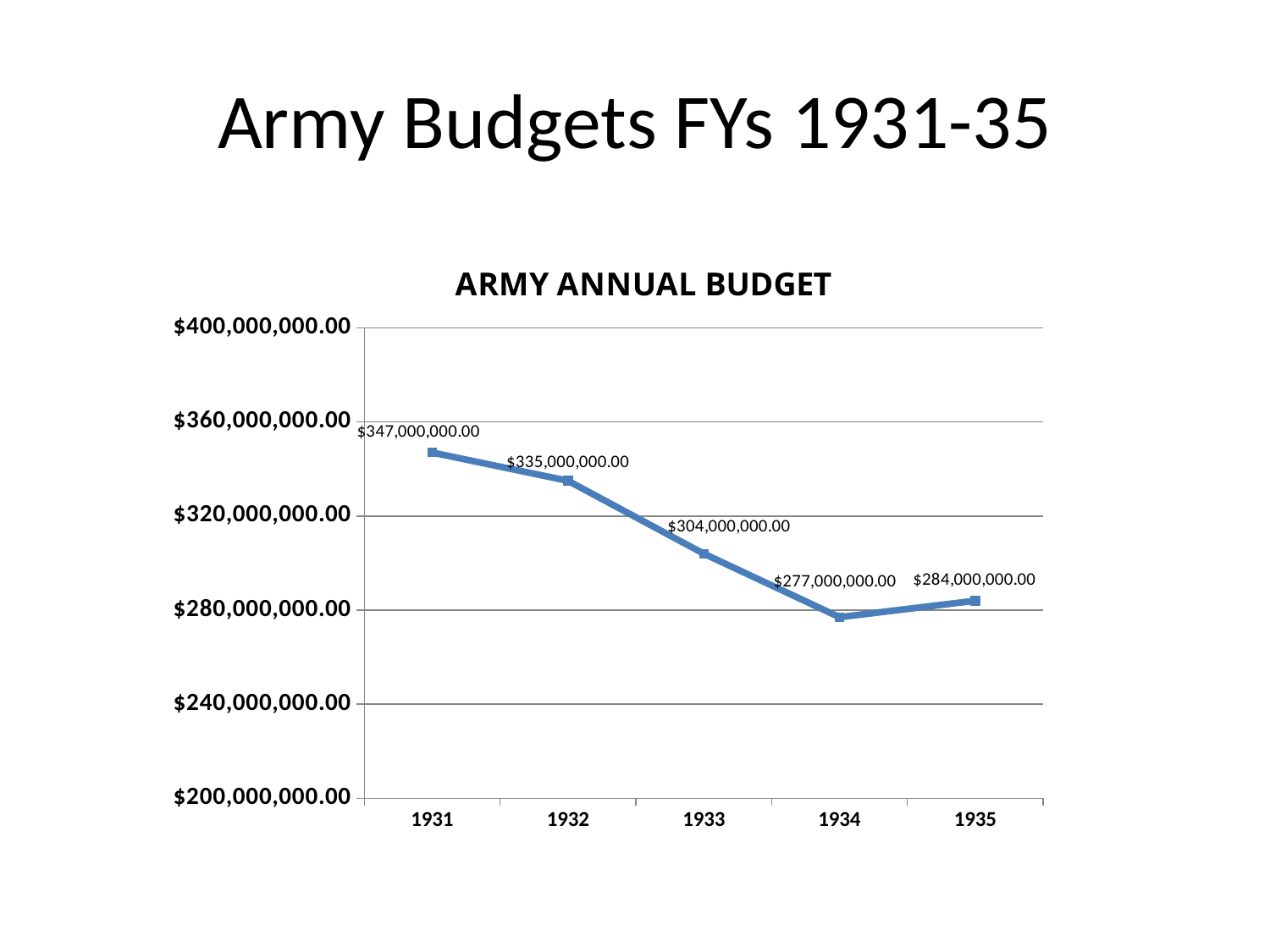
Is the value for 1933 greater or less than $320,000,000.00? less Which year has the lowest Army annual budget? 1934 What kind of chart is shown? line chart What is the difference between the 1931 and 1932 budgets? $12,000,000.00 How many years are plotted on the chart? 5 What is the Army annual budget for 1931? $347,000,000.00 Which year has the highest Army annual budget? 1931 What is the Army annual budget for 1935? $284,000,000.00 What is the Army annual budget for 1934? $277,000,000.00 Which year has a larger budget, 1934 or 1935? 1935 What is the difference between the 1933 and 1934 budgets? $27,000,000.00 What is the title of the chart? ARMY ANNUAL BUDGET